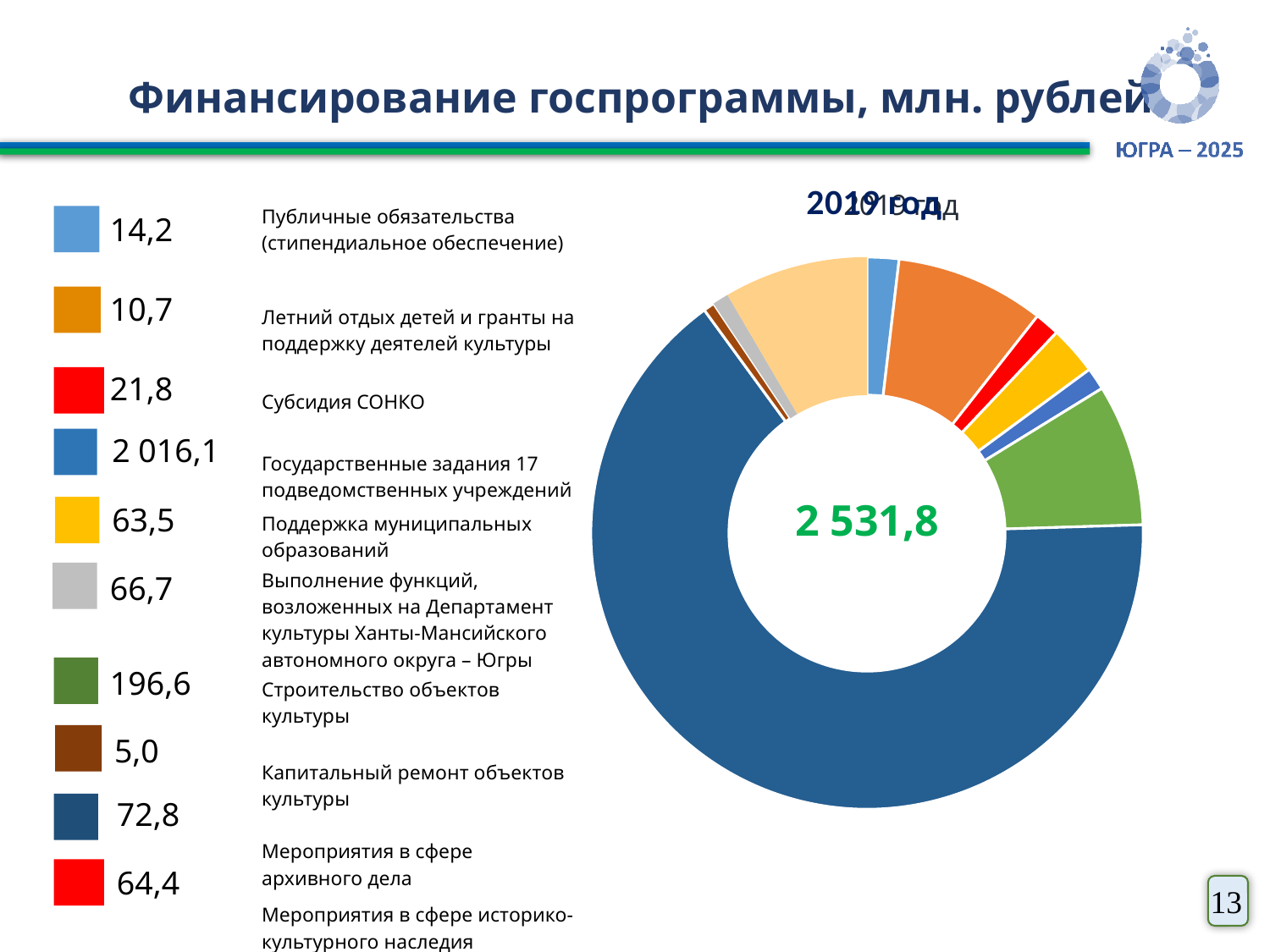
What is the value for Мероприятия в сфере архивного дела? 72,8 What kind of chart is shown on the slide? Pie (donut) chart What is the value for Государственные задания 17 подведомственных учреждений? 2 016,1 What is the difference between Выполнение функций, возложенных на Департамент культуры (66,7) and Поддержка муниципальных образований (63,5)? 3,2 What is the value for Субсидия СОНКО? 21,8 Which category has the smallest value? Капитальный ремонт объектов культуры What is the total value shown in the centre of the donut chart? 2 531,8 Which category has the largest value? Государственные задания 17 подведомственных учреждений What is the value for Строительство объектов культуры? 196,6 Which is larger: Публичные обязательства (стипендиальное обеспечение) or Летний отдых детей и гранты на поддержку деятелей культуры? Публичные обязательства (стипендиальное обеспечение) What is the title of the slide? Финансирование госпрограммы, млн. рублей How many categories are listed in the legend of the chart? 10